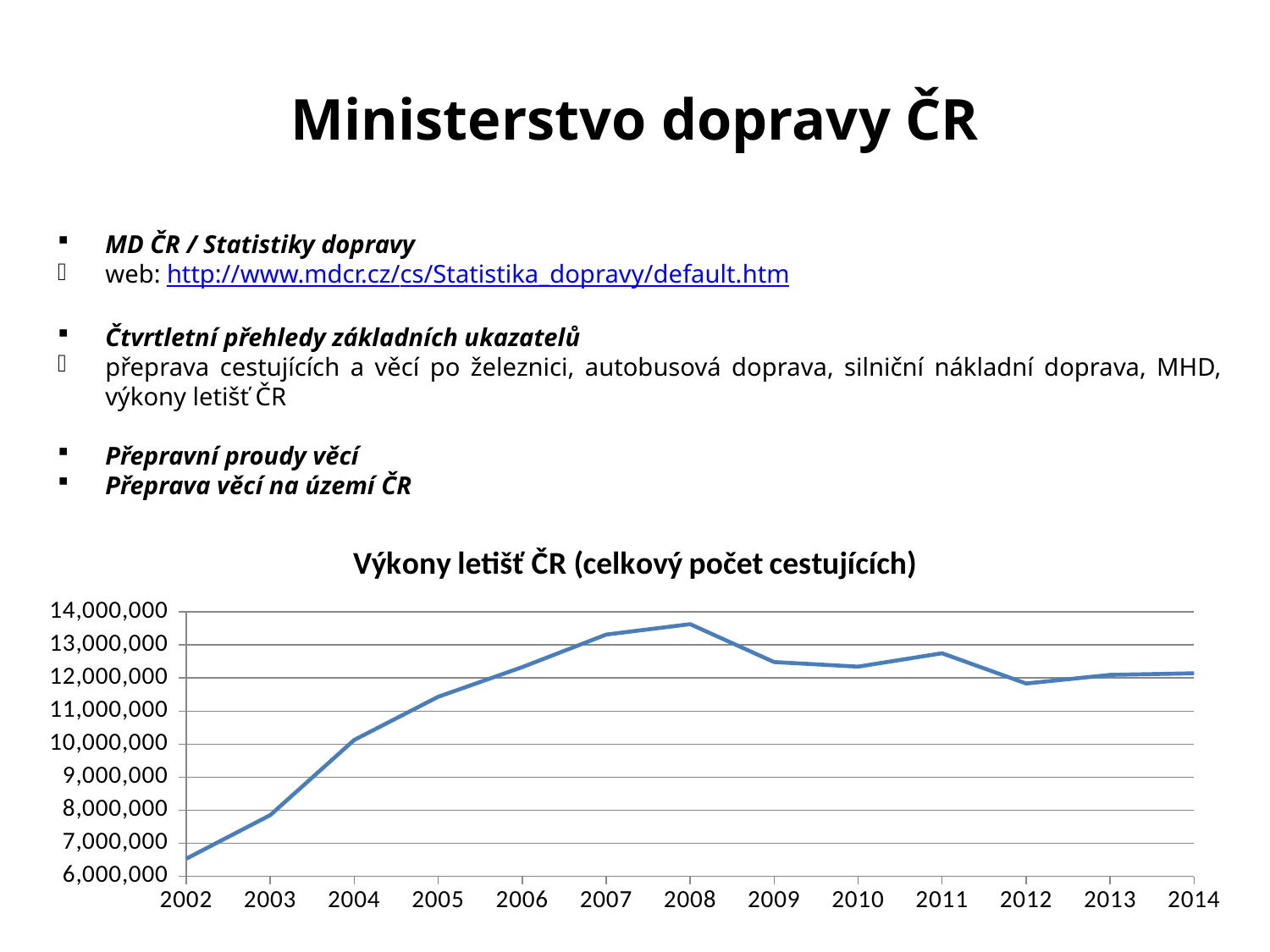
Which year has the larger value, 2003 or 2004? 2004 In which year is the total number of passengers lowest? 2002 How many years are plotted on the x axis of the chart? 13 What type of chart is shown on the slide? line chart What is the title of the chart? Výkony letišť ČR (celkový počet cestujících) Is the value for 2002 greater or less than 7,000,000? less Which year has the larger value, 2007 or 2009? 2007 Do the values rise or fall from 2002 to 2008? rise In which year is the total number of passengers highest? 2008 Is the value for 2008 greater or less than 13,000,000? greater